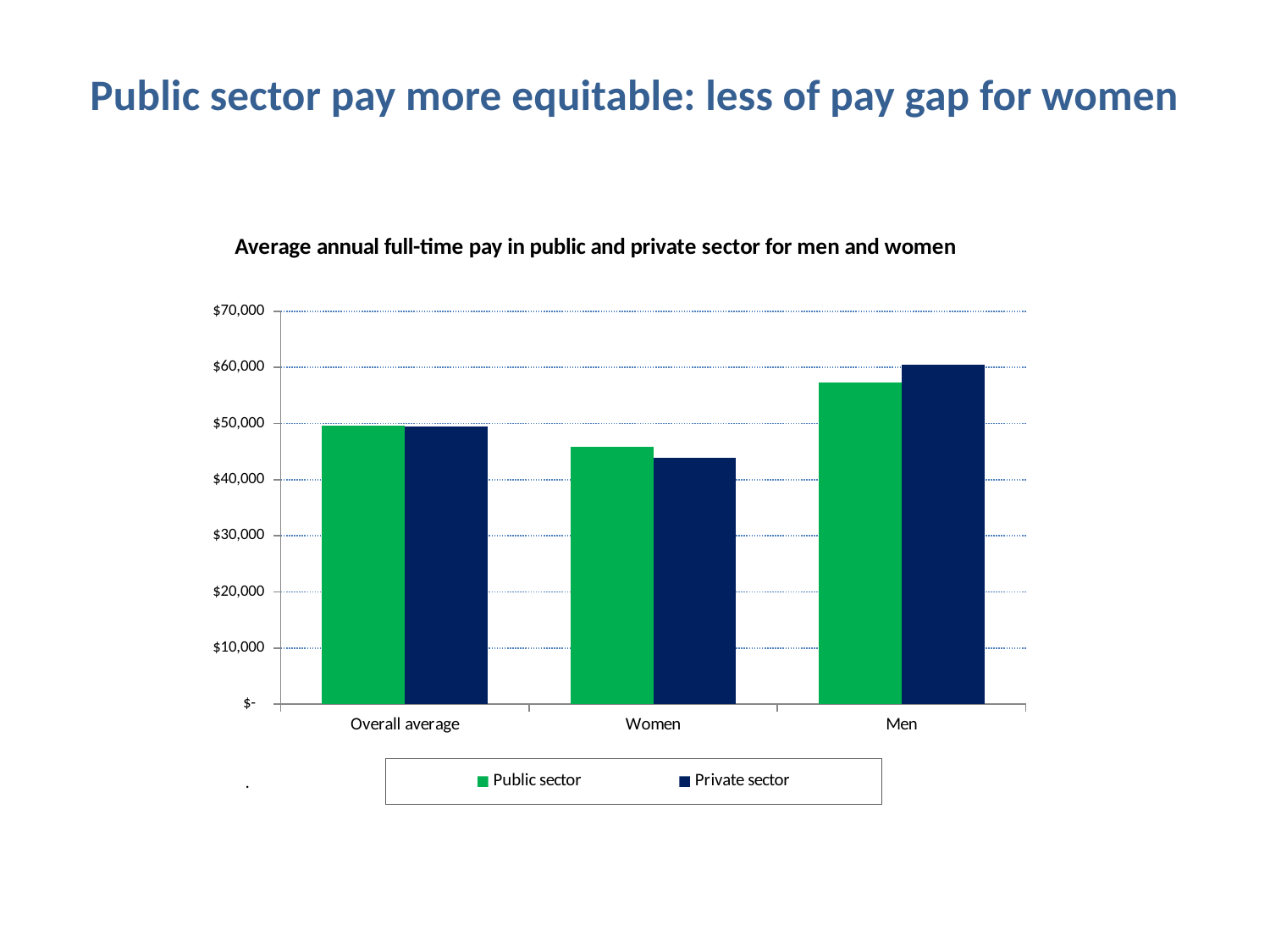
How many categories are shown on the x axis of the chart? 3 Which colour represents the Private sector series in the chart? dark blue Is the Private sector value for Men greater or less than $50,000? greater Is the Private sector value for Women greater or less than $50,000? less Which category has the highest Private sector value? Men How many series does the legend list? 2 Is the Public sector value for Men greater or less than $60,000? less What is the title of the chart? Average annual full-time pay in public and private sector for men and women For Men, which is larger: the Public sector value or the Private sector value? Private sector For Women, which is larger: the Public sector value or the Private sector value? Public sector What kind of chart is shown on the slide? bar chart Which category has the lowest Public sector value? Women